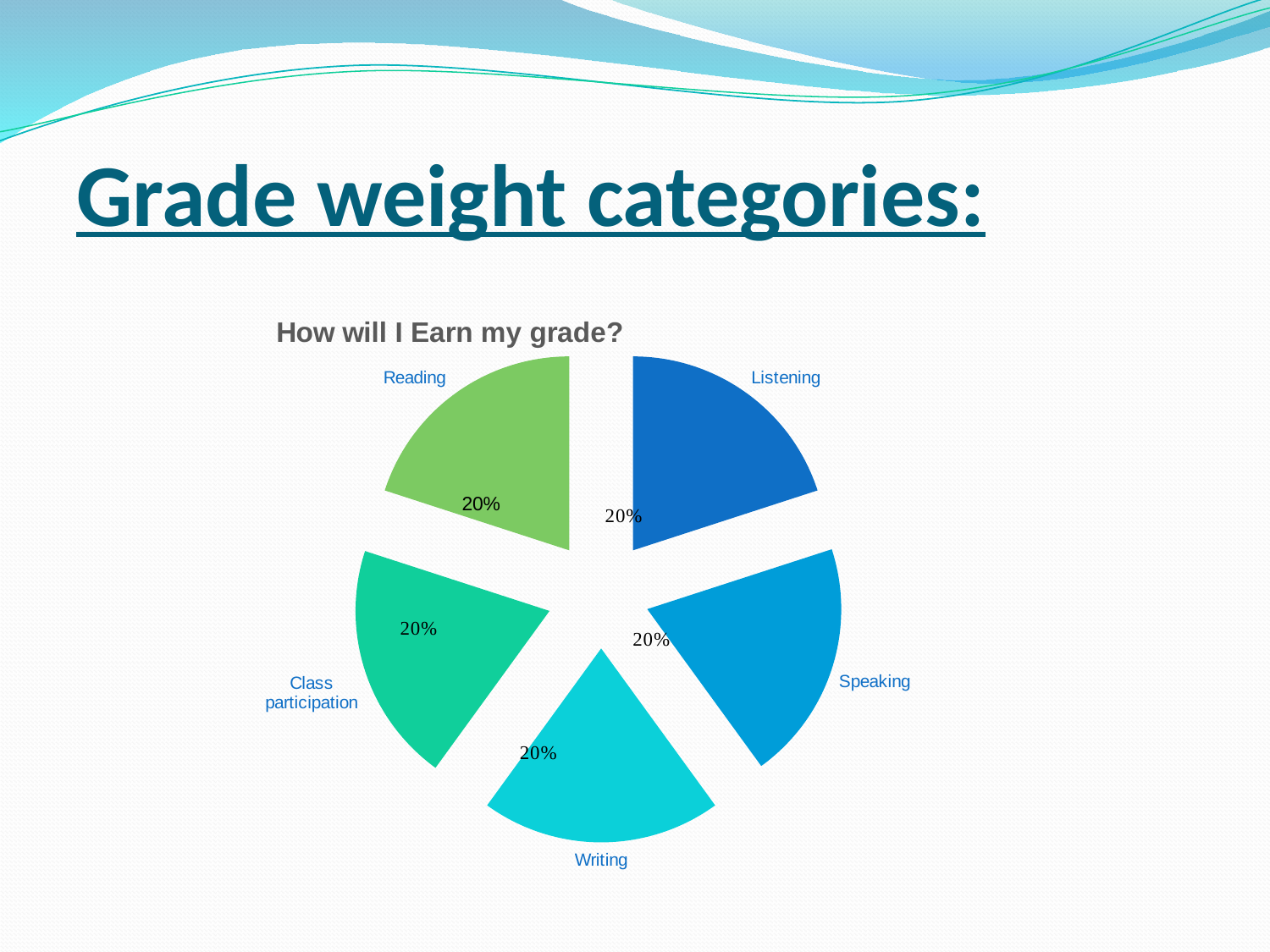
What is the title of the chart? How will I Earn my grade? How many categories does the pie chart have? 5 What percentage of the grade is Class participation? 20% Do all five categories have the same weight? Yes What percentage of the grade is Writing? 20% What kind of chart is shown on the slide? pie chart What percentage of the grade is Speaking? 20% What share of the pie does the Writing slice represent? 20% What percentage of the grade is Reading? 20% Which category is shown in the dark blue slice? Listening What percentage of the grade is Listening? 20% What is the difference between the Reading and Listening percentages? 0%